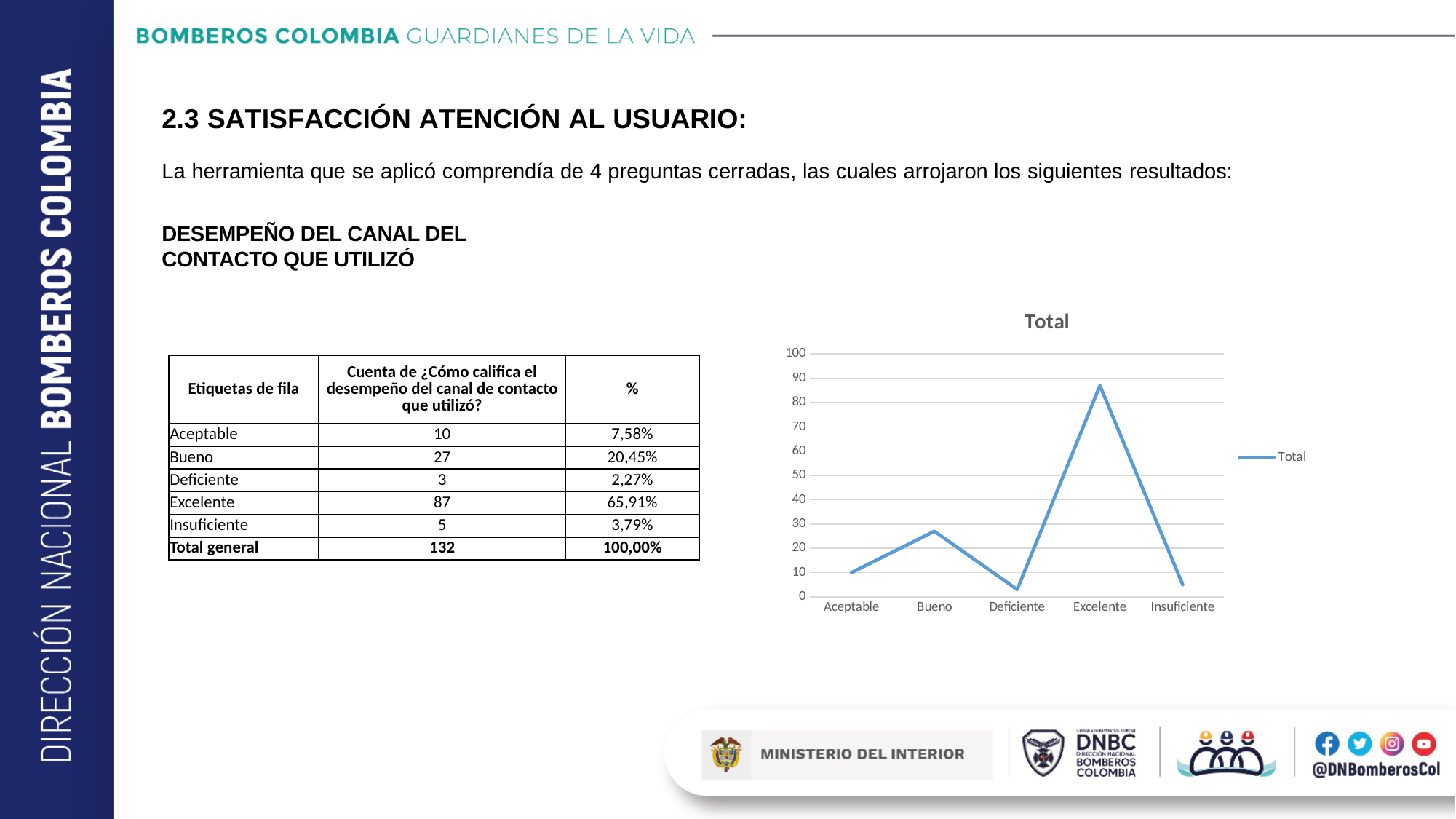
What is the title of the chart? Total Is the value for Excelente greater or less than 80? greater Is the value for Bueno greater or less than 30? less How many categories are shown on the x axis of the chart? 5 Is the value for Insuficiente greater or less than 10? less Which category has the highest value in the chart? Excelente What is the value for Excelente in the chart? 87 Which is larger, the value for Bueno or the value for Aceptable? Bueno Which category has the lowest value in the chart? Deficiente How many series does the chart legend list? 1 What kind of chart is shown on the slide? line chart What is the difference between the values for Excelente and Bueno? 60